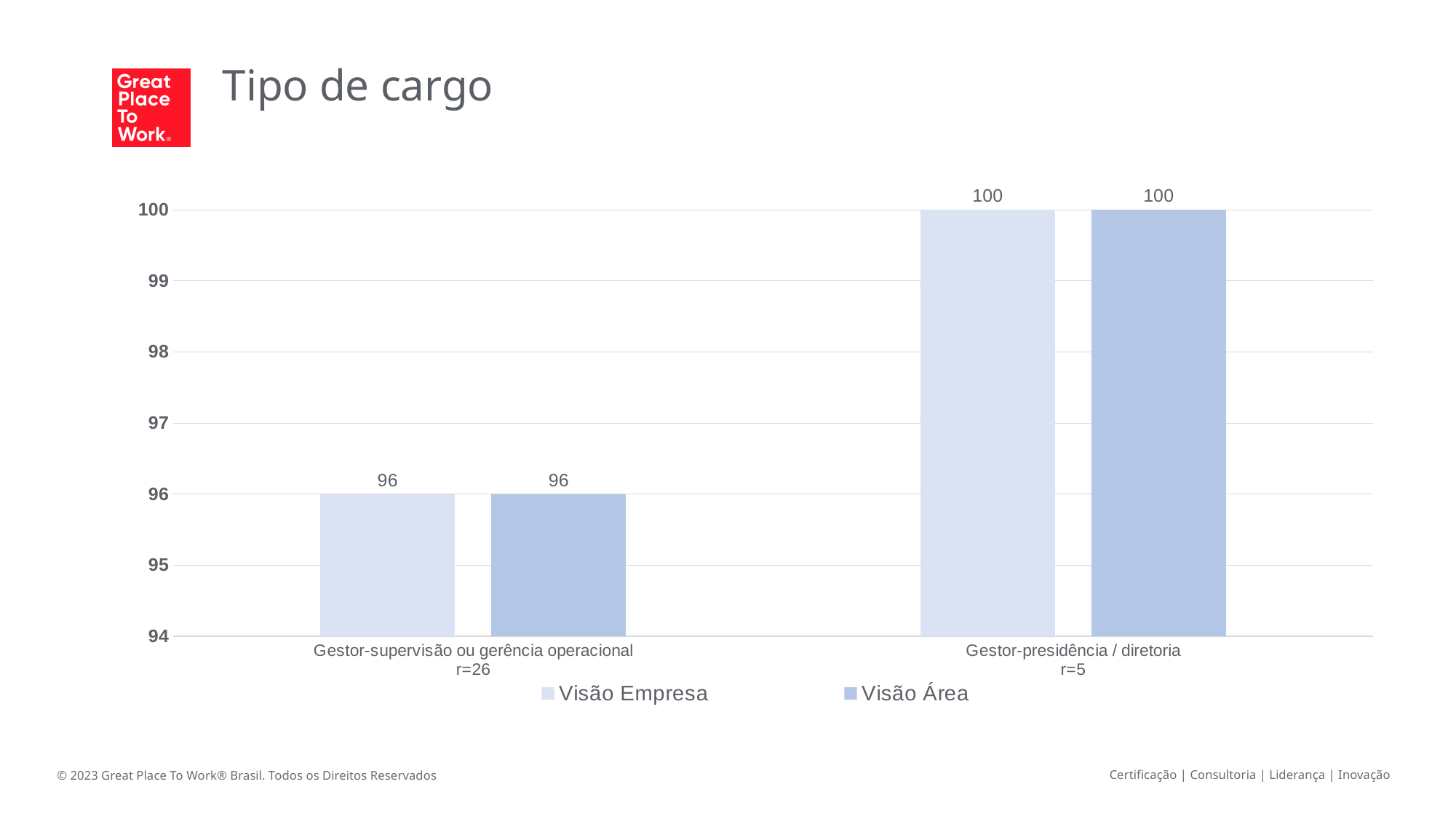
What is the Visão Área value for Gestor-presidência / diretoria? 100 What is the title of the slide? Tipo de cargo Which is larger: the Visão Área value for Gestor-presidência / diretoria or for Gestor-supervisão ou gerência operacional? Gestor-presidência / diretoria Which category has the lowest Visão Área value? Gestor-supervisão ou gerência operacional How many categories are shown on the x axis? 2 How many series does the legend list? 2 What kind of chart is shown on the slide? Bar chart What is the Visão Área value for Gestor-supervisão ou gerência operacional? 96 What is the r value shown under the Gestor-presidência / diretoria category? r=5 What is the Visão Empresa value for Gestor-supervisão ou gerência operacional? 96 What is the difference between the Visão Empresa values for Gestor-presidência / diretoria and Gestor-supervisão ou gerência operacional? 4 Which category has the highest Visão Empresa value? Gestor-presidência / diretoria